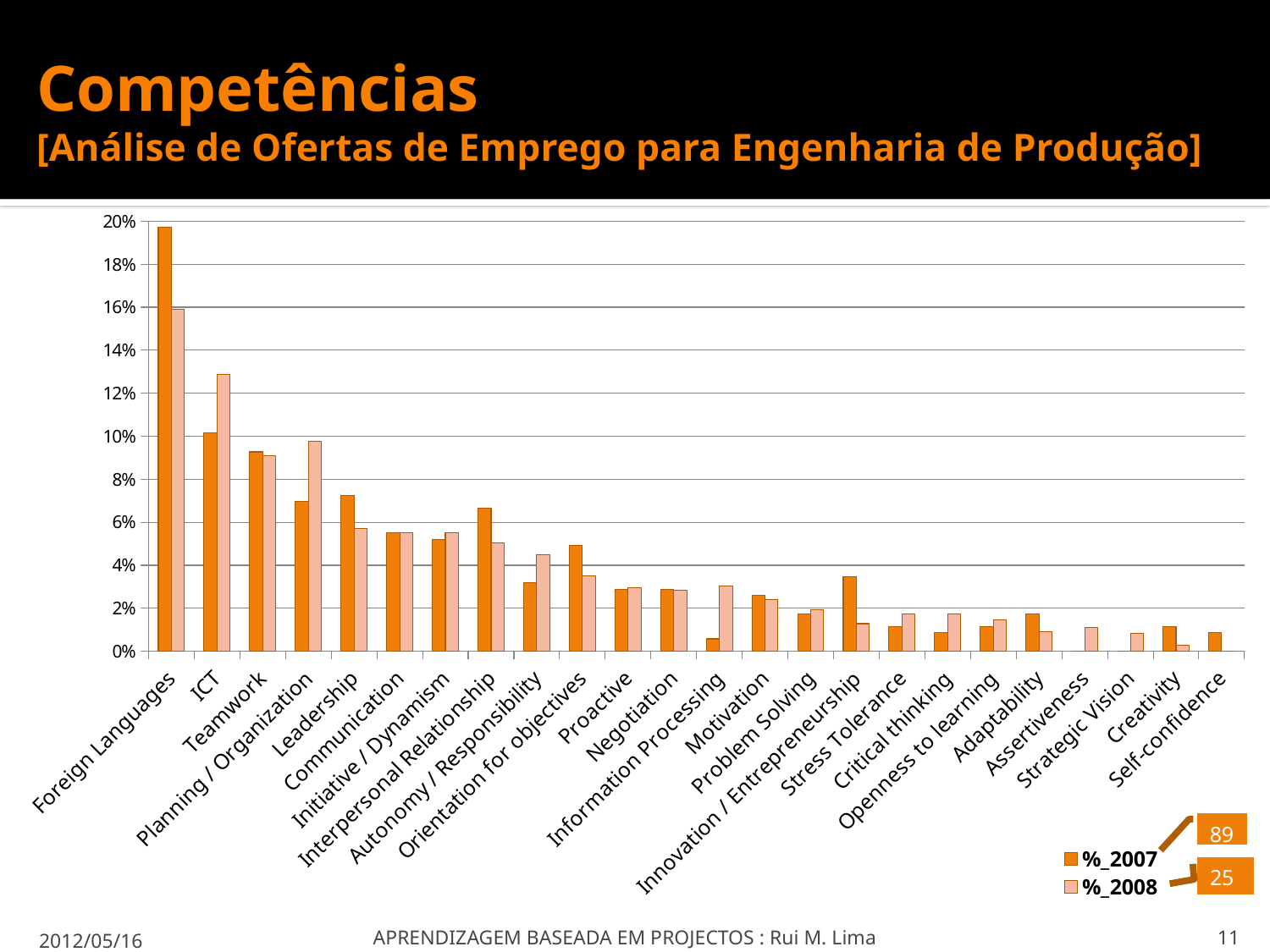
Do the %_2007 values generally rise or fall from left to right along the x axis? fall Is the %_2007 value for Foreign Languages greater or less than 18%? greater What kind of chart is shown on the slide? bar chart For Innovation / Entrepreneurship, which series has the larger value, %_2007 or %_2008? %_2007 What are the two series names shown in the legend? %_2007 and %_2008 Is the %_2007 value for Information Processing greater or less than 2%? less How many series does the legend list? 2 Which category has the highest value for %_2007? Foreign Languages For ICT, which series has the larger value, %_2007 or %_2008? %_2008 How many competency categories are shown on the x axis? 24 Which category has the highest value for %_2008? Foreign Languages Is the %_2008 value for ICT greater or less than 12%? greater